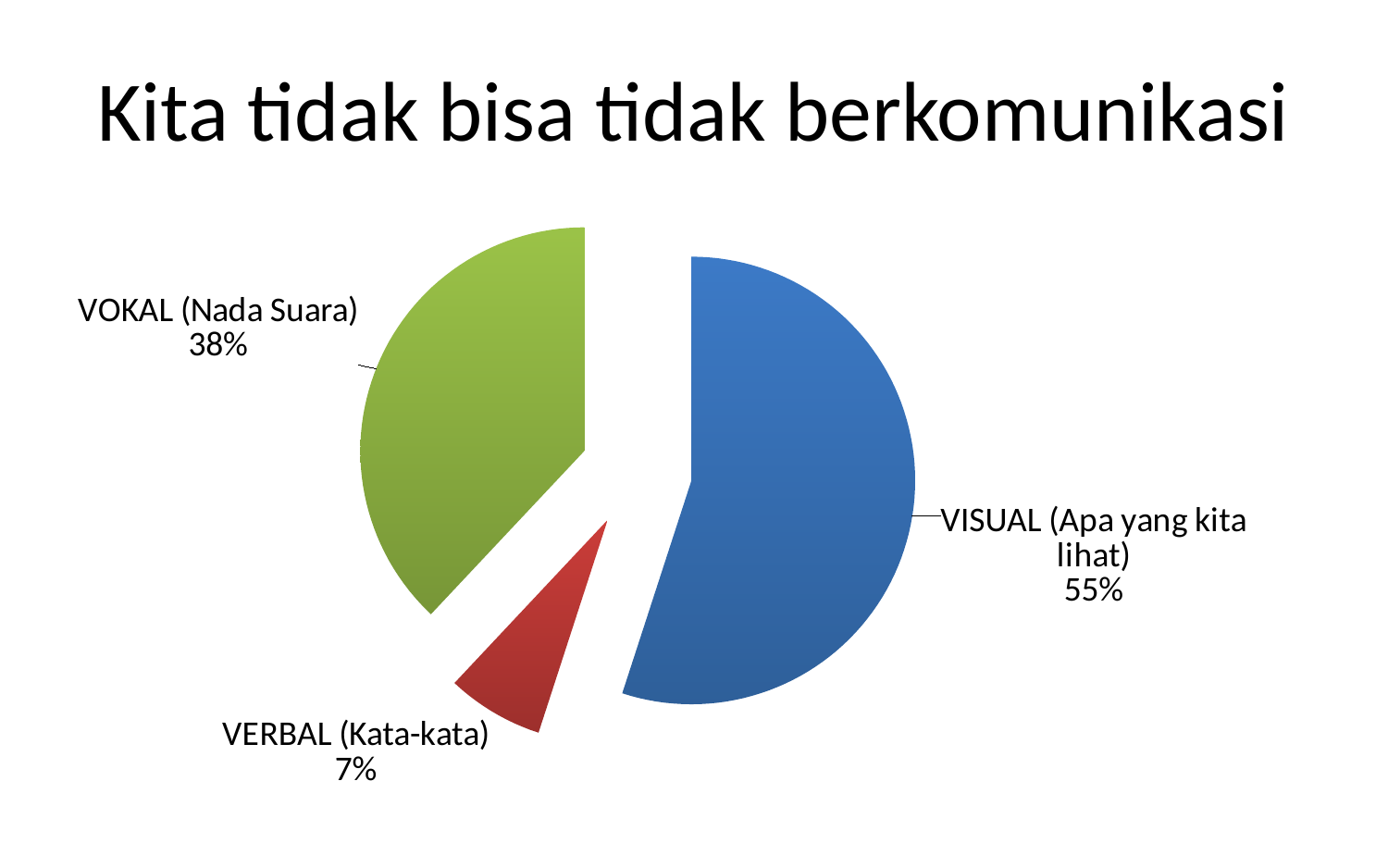
What share of the pie does VISUAL (Apa yang kita lihat) have? 55% Which is larger, the share for VOKAL (Nada Suara) or the share for VERBAL (Kata-kata)? VOKAL (Nada Suara) What share of the pie does VOKAL (Nada Suara) have? 38% What kind of chart is shown on the slide? pie chart What colour is the VISUAL (Apa yang kita lihat) slice? blue What share of the pie does VERBAL (Kata-kata) have? 7% Which slice of the pie is the smallest? VERBAL (Kata-kata) Which slice of the pie is the largest? VISUAL (Apa yang kita lihat) How many slices does the pie chart have? 3 What is the title of the slide? Kita tidak bisa tidak berkomunikasi What is the difference in percentage points between VOKAL (Nada Suara) and VERBAL (Kata-kata)? 31 What is the difference in percentage points between VISUAL (Apa yang kita lihat) and VOKAL (Nada Suara)? 17